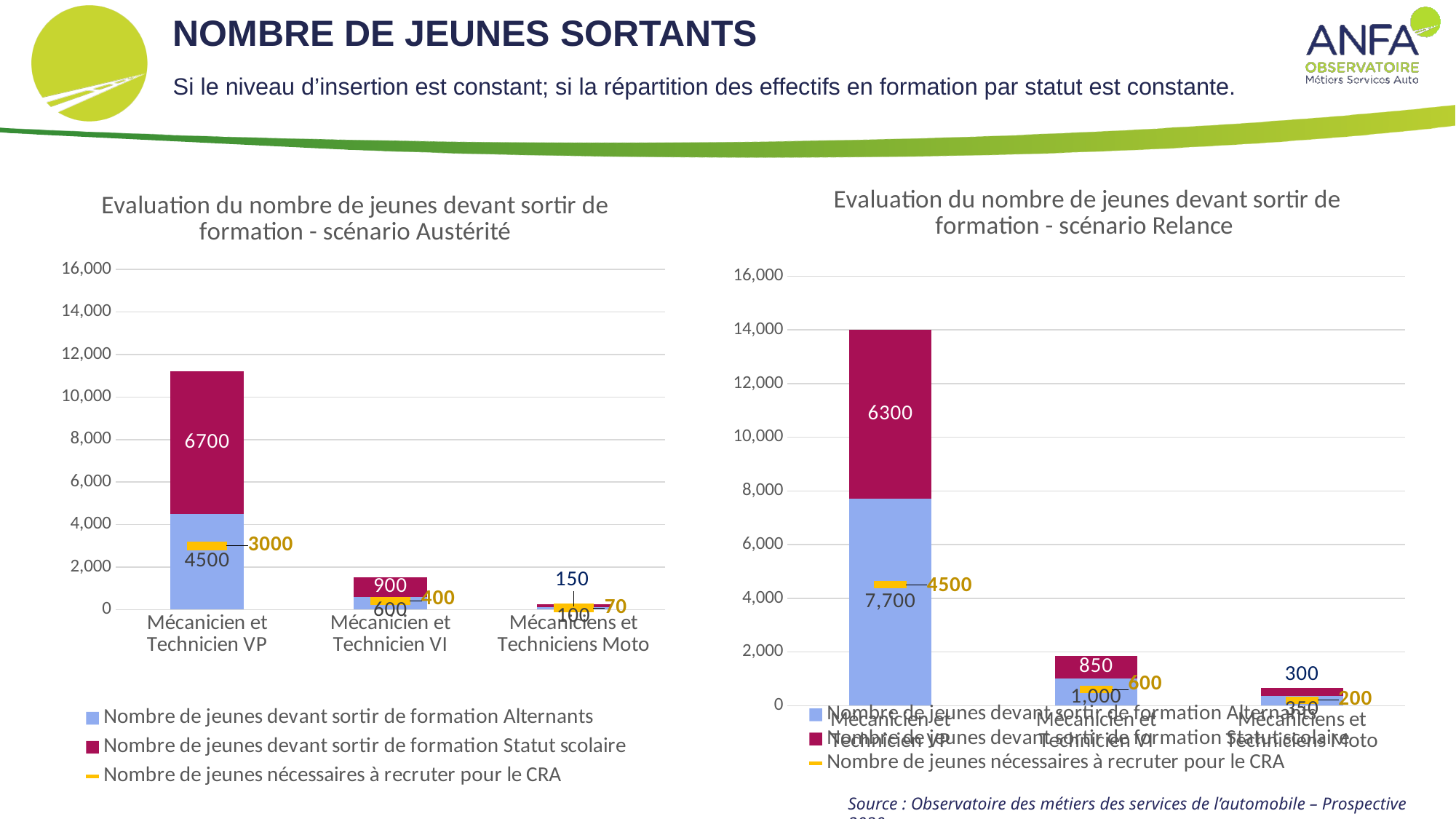
In the scénario Relance chart, which category has the lowest total stacked bar? Mécaniciens et Techniciens Moto What kind of chart is the scénario Relance chart? Stacked bar chart How many series does the legend of the scénario Austérité chart list? 3 In the scénario Relance chart, what is the total of the stacked bar for Mécanicien et Technicien VI (Alternants plus Statut scolaire)? 1,850 What is the difference between the Statut scolaire value for Mécanicien et Technicien VP in the scénario Austérité chart and in the scénario Relance chart? 400 In the scénario Relance chart, is the Alternants value for Mécanicien et Technicien VP larger or smaller than the Statut scolaire value for the same category? larger In the scénario Relance chart, what is the value for Nombre de jeunes nécessaires à recruter pour le CRA for Mécaniciens et Techniciens Moto? 200 In the scénario Austérité chart, what is the total of the stacked bar for Mécanicien et Technicien VP (Alternants plus Statut scolaire)? 11200 In the scénario Austérité chart, what is the value for Nombre de jeunes nécessaires à recruter pour le CRA for Mécanicien et Technicien VI? 400 In the scénario Austérité chart, which category has the highest total stacked bar? Mécanicien et Technicien VP In the scénario Relance chart, what is the value for Nombre de jeunes devant sortir de formation Alternants for Mécanicien et Technicien VP? 7,700 In the scénario Austérité chart, what is the value for Nombre de jeunes devant sortir de formation Statut scolaire for Mécanicien et Technicien VP? 6700